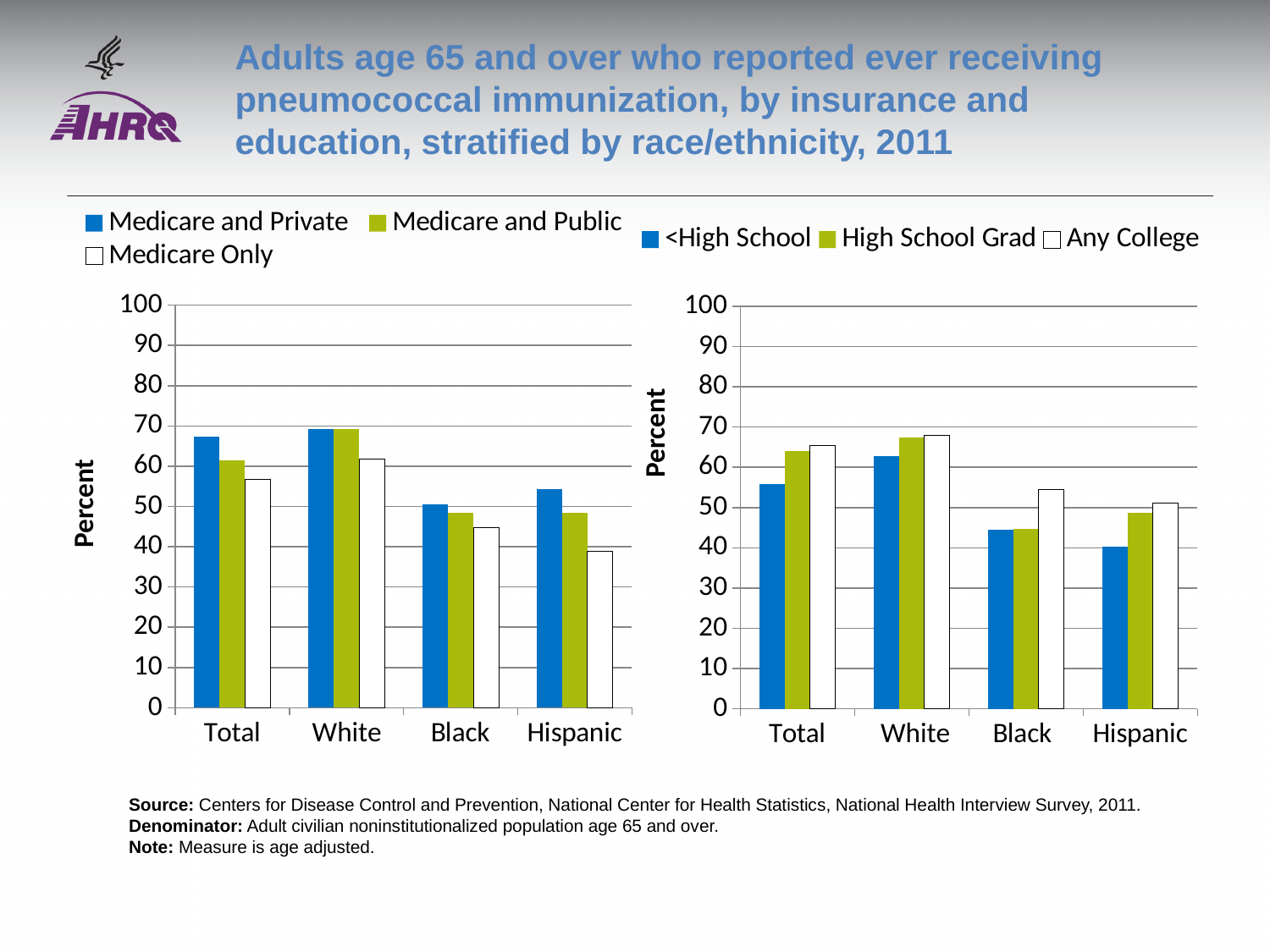
In the left chart (by insurance), which category has the lowest Medicare Only value? Hispanic In the right chart (by education), which category has the lowest <High School value? Hispanic In the right chart (by education), is the value for <High School for Hispanic greater or less than 50? less In the left chart (by insurance), is the value for Medicare Only for Hispanic greater or less than 50? less How many series does the legend of the left chart (by insurance) list? 3 In the left chart (by insurance), which is larger for Hispanic: Medicare and Private or Medicare Only? Medicare and Private How many series does the legend of the right chart (by education) list? 3 What kind of chart is the left chart (by insurance)? bar chart In the left chart (by insurance), is the value for Medicare and Private for White greater or less than 60? greater How many race/ethnicity categories are shown on the x axis of the right chart (by education)? 4 In the right chart (by education), which is larger for Black: Any College or <High School? Any College